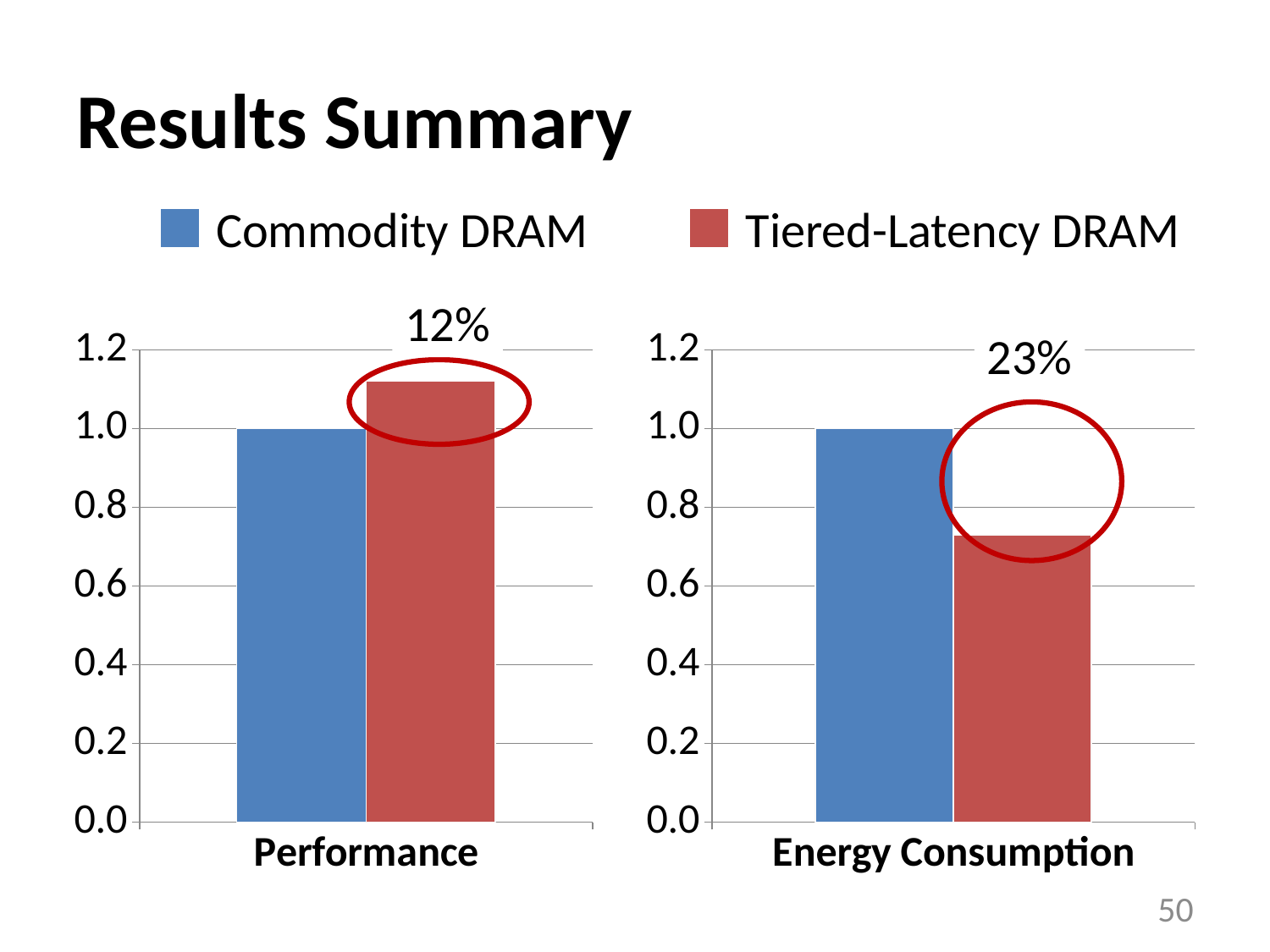
Which colour represents Tiered-Latency DRAM in the legend? red In the Performance chart, is the value for Tiered-Latency DRAM greater or less than 1.0? greater In the Performance chart, what is the value for Commodity DRAM? 1.0 How many series does the legend list? 2 In the Energy Consumption chart, which series has the lower bar? Tiered-Latency DRAM How many categories are shown on the x axis of the Energy Consumption chart? 1 What kind of chart is the Performance chart? bar chart In the Performance chart, which series has the higher bar, Commodity DRAM or Tiered-Latency DRAM? Tiered-Latency DRAM What percentage annotation is printed above the Tiered-Latency DRAM bar in the Performance chart? 12% In the Energy Consumption chart, what is the value for Commodity DRAM? 1.0 In the Energy Consumption chart, which series has the higher bar? Commodity DRAM In the Energy Consumption chart, is the value for Tiered-Latency DRAM greater or less than 0.8? less